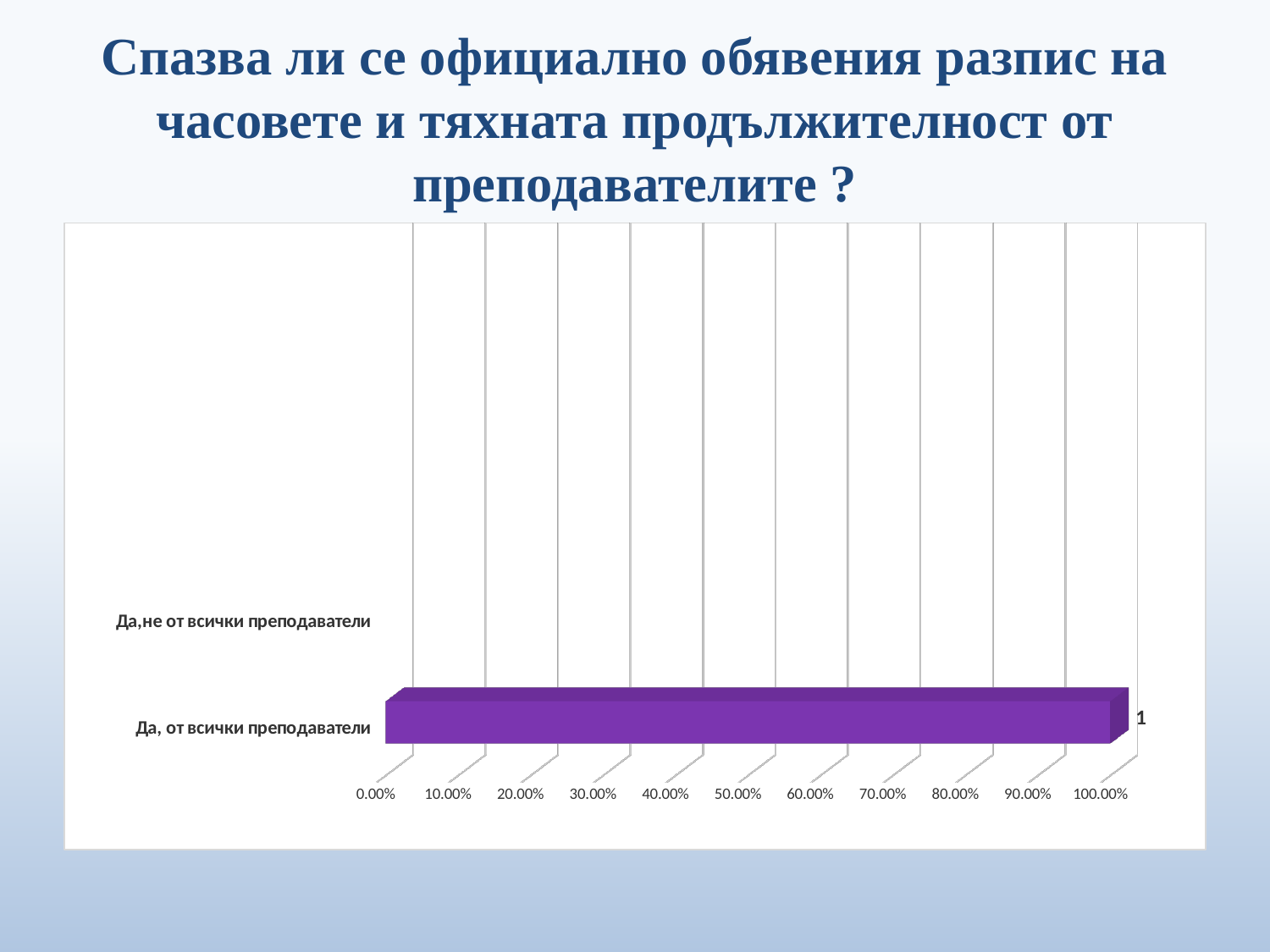
What is the highest tick label shown on the horizontal axis? 100.00% Is the value for "Да, от всички преподаватели" greater or less than 90.00%? greater What colour is the bar on the chart? Purple Which category has the highest value? Да, от всички преподаватели What data label is printed on the bar for "Да, от всички преподаватели"? 1 Which is larger: the value for "Да, от всички преподаватели" or for "Да,не от всички преподаватели"? Да, от всички преподаватели Which category has the lowest value? Да,не от всички преподаватели How many categories are shown on the chart? 2 Is the value for "Да, от всички преподаватели" greater or less than 50.00%? greater What kind of chart is shown on the slide? Bar chart